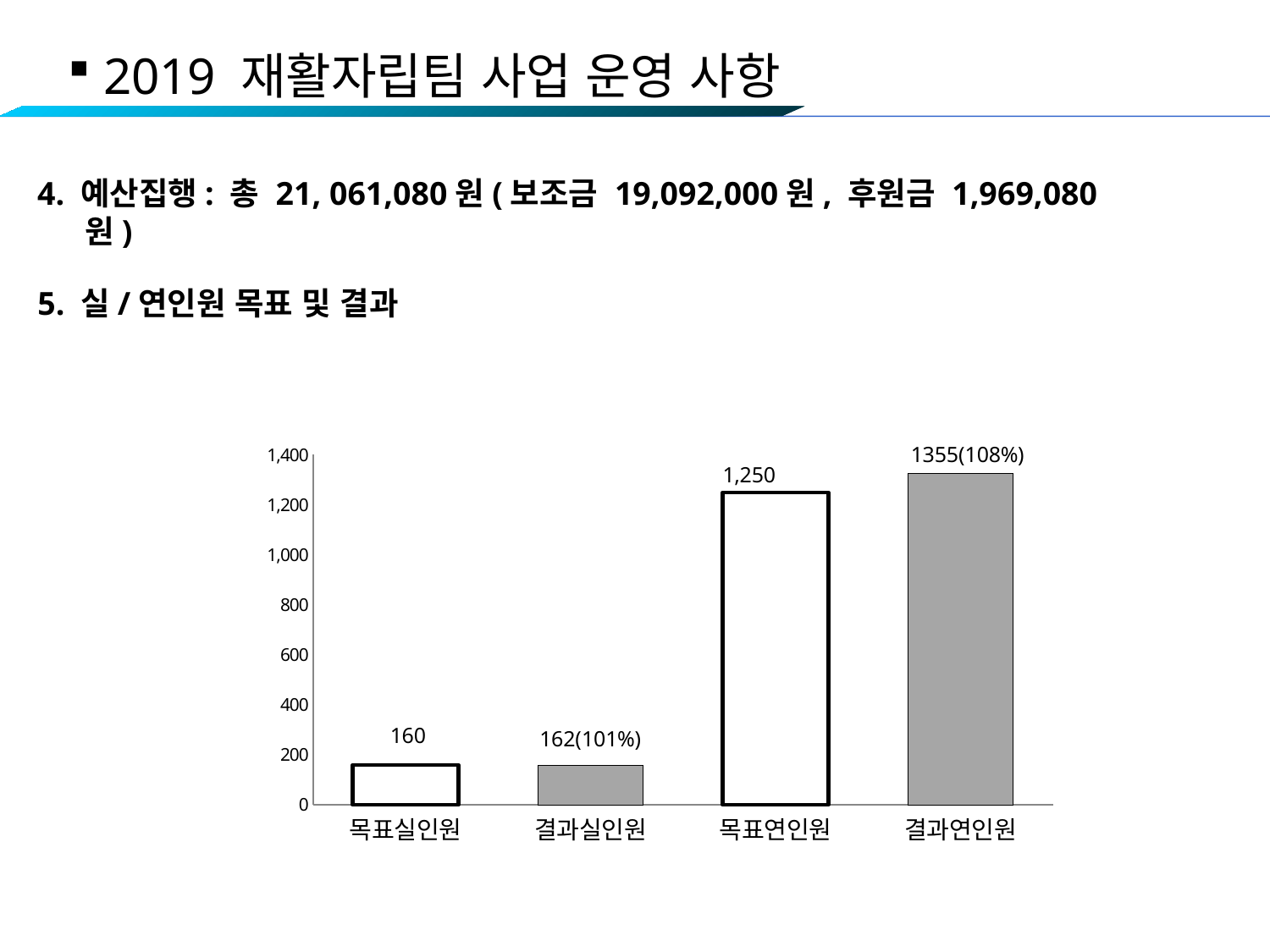
What data label is shown for 결과연인원? 1355(108%) Is the value for 목표연인원 greater or less than 1,000? greater Which category has the lowest value? 목표실인원 What is the difference between the values for 결과연인원 and 목표연인원? 105 Which category has the highest value? 결과연인원 What is the difference between the values for 결과실인원 and 목표실인원? 2 What is the value shown for 목표연인원? 1,250 How many categories are shown on the x axis? 4 What kind of chart is shown on the slide? bar chart Which is larger, the value for 목표연인원 or the value for 결과연인원? 결과연인원 What is the value shown for 목표실인원? 160 What data label is shown for 결과실인원? 162(101%)